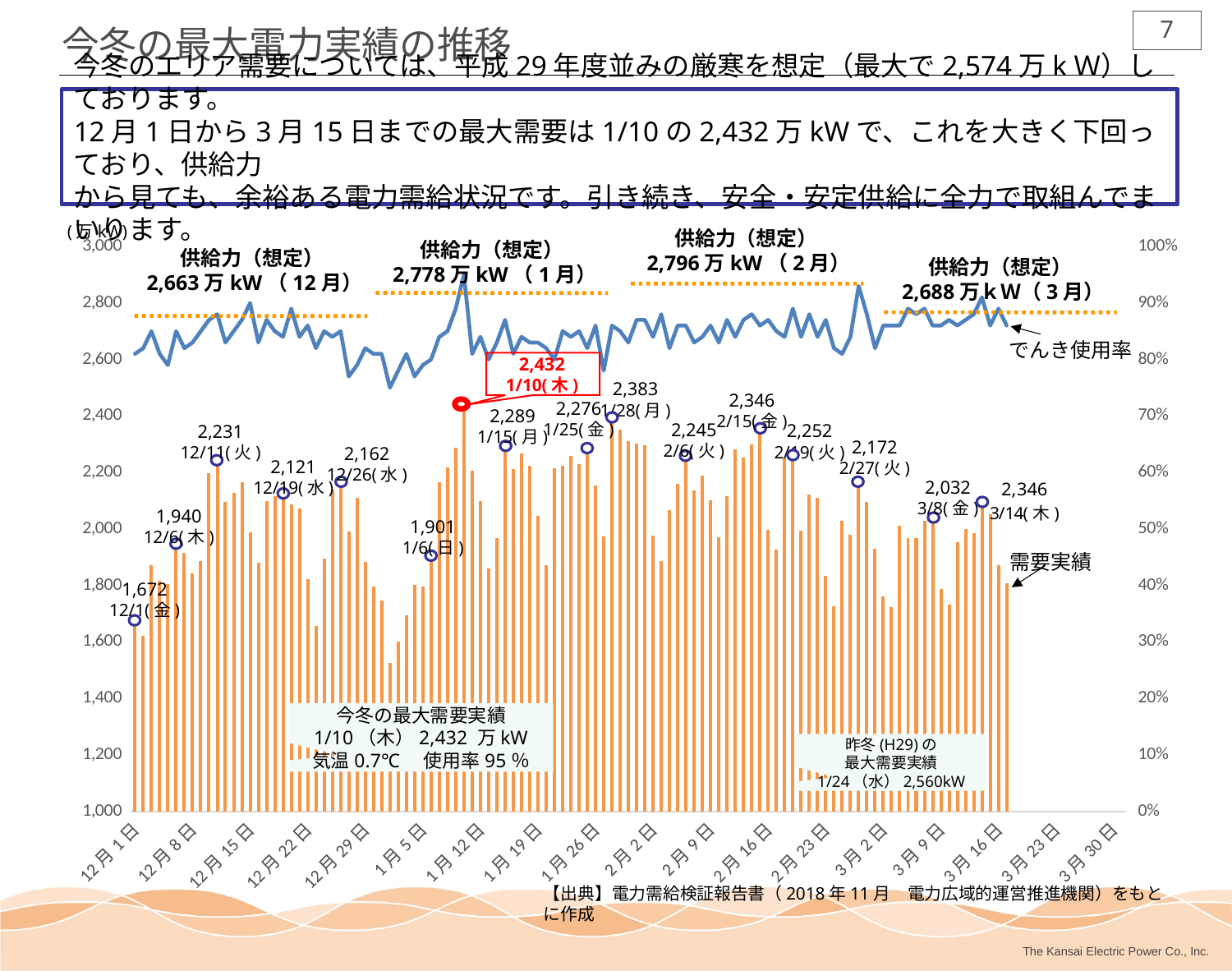
Which is larger, the labeled demand value for 12/11 (火) or for 2/6 (火)? 2/6(火) What is the difference between the labeled demand values for 1/10 (木) and 1/28 (月)? 49 What is the labeled demand value for 1/10 (木) on the chart? 2,432 What is the labeled demand value for 3/8 (金)? 2,032 What kind of chart is used to show the 需要実績 (demand) series? Bar chart Which labeled date has the highest demand value on the chart? 1/10(木) What is the assumed supply capacity (供給力（想定）) shown for February (2月)? 2,796万kW What is the labeled demand value for 1/28 (月)? 2,383 What does the blue line on the chart represent? でんき使用率 Which labeled date has the lowest demand value on the chart? 12/1(金) What is the labeled demand value for 12/1 (金)? 1,672 What is the difference between the assumed supply capacity for January (2,778万kW) and December (2,663万kW)? 115万kW